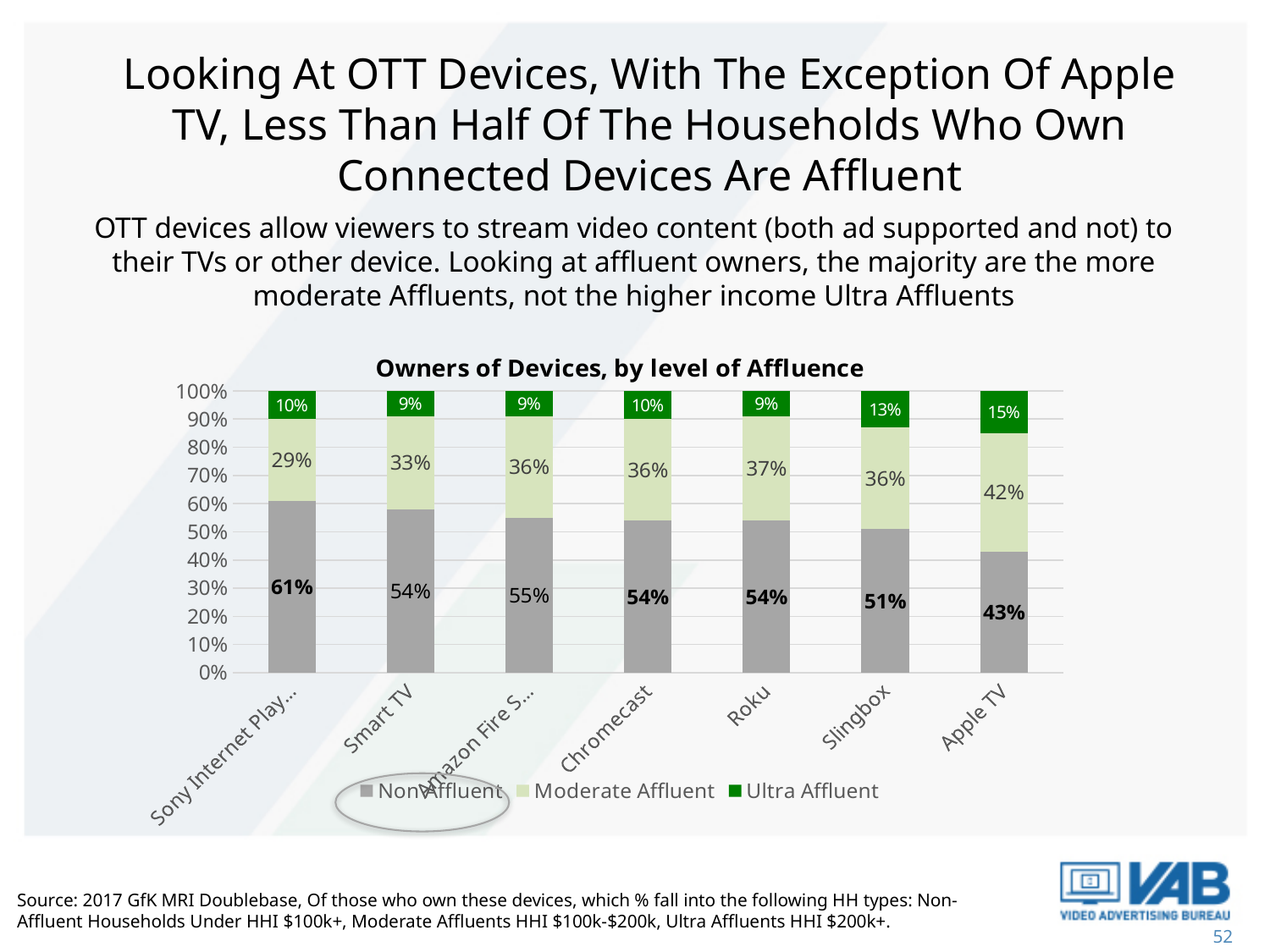
What type of chart is shown on the slide? Stacked bar chart For Apple TV, what is the difference between the Moderate Affluent and Ultra Affluent shares? 27 percentage points What is the Ultra Affluent share for Slingbox? 13% How many series does the chart's legend list? 3 What is the Ultra Affluent value for Chromecast? 10% What is the Moderate Affluent value for Roku? 37% Which has a larger Moderate Affluent share, Chromecast or Smart TV? Chromecast How many devices are shown on the x axis of the chart? 7 Which device has the lowest Non Affluent share? Apple TV What percentage of Apple TV owners are Non Affluent? 43% How many percentage points higher is the Non Affluent share for Smart TV than for Apple TV? 11 percentage points Which device has the highest Ultra Affluent share? Apple TV